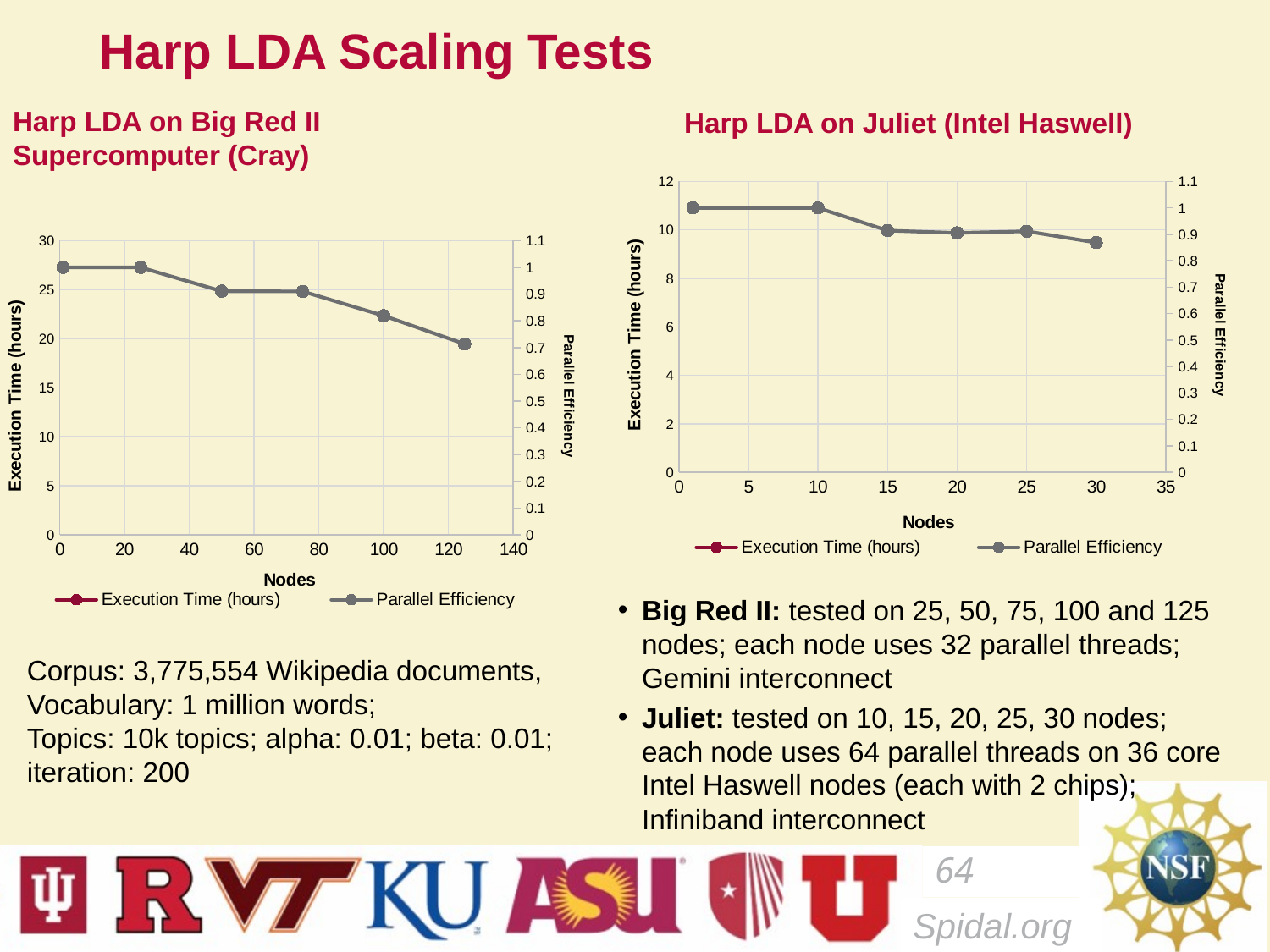
In the Harp LDA on Juliet (Intel Haswell) chart, is Parallel Efficiency higher at 10 nodes or at 30 nodes? 10 nodes What is the title of the right-hand vertical axis in the Harp LDA on Big Red II Supercomputer (Cray) chart? Parallel Efficiency In the Harp LDA on Big Red II Supercomputer (Cray) chart, is the Parallel Efficiency at 125 nodes greater or less than 0.8? less What is the title of the x axis in the Harp LDA on Juliet (Intel Haswell) chart? Nodes How many series does the legend of the Harp LDA on Juliet (Intel Haswell) chart list? 2 In the Harp LDA on Juliet (Intel Haswell) chart, is the Parallel Efficiency at 15 nodes greater or less than 1? less In the Harp LDA on Juliet (Intel Haswell) chart, does Parallel Efficiency rise or fall as the number of nodes increases? fall In the Harp LDA on Big Red II Supercomputer (Cray) chart, at which number of nodes is Parallel Efficiency lowest? 125 In the Harp LDA on Big Red II Supercomputer (Cray) chart, does Parallel Efficiency rise or fall as the number of nodes increases? fall In the Harp LDA on Juliet (Intel Haswell) chart, is the Parallel Efficiency at 30 nodes greater or less than 0.8? greater What kind of chart is the Harp LDA on Big Red II Supercomputer (Cray) chart? line chart